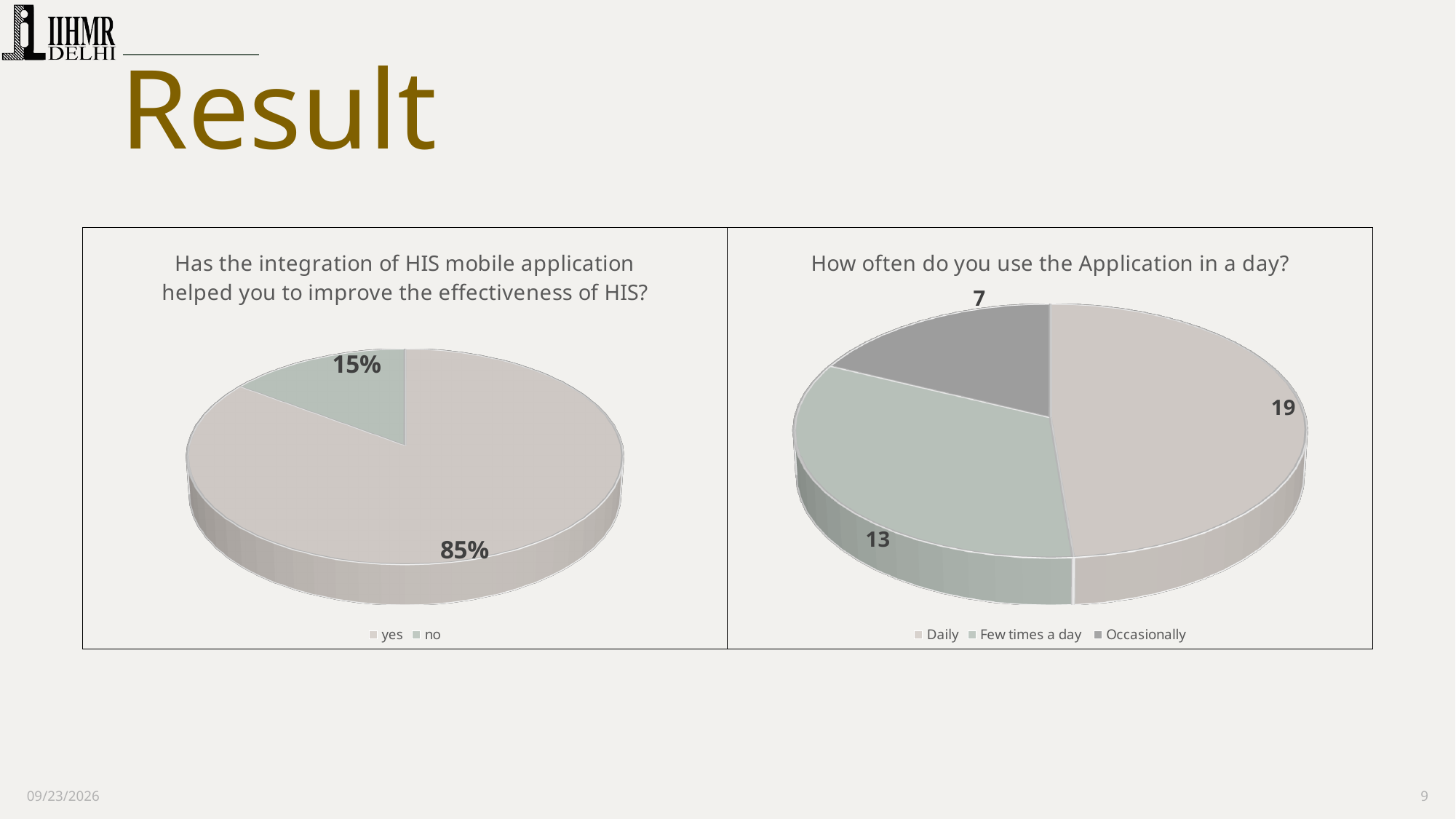
In the left chart, what is the difference in percentage points between the 'yes' and 'no' slices? 70 In the right chart, what is the difference between the 'Daily' and 'Few times a day' values? 6 In the right chart titled 'How often do you use the Application in a day?', what is the value for 'Daily'? 19 What kind of chart is the left chart on the slide? Pie chart In the left chart, which response has the larger share, 'yes' or 'no'? yes In the right chart, which category has the highest value? Daily In the right chart titled 'How often do you use the Application in a day?', what is the value for 'Occasionally'? 7 In the left chart titled 'Has the integration of HIS mobile application helped you to improve the effectiveness of HIS?', what percentage answered 'no'? 15% In the right chart, which category has the lowest value? Occasionally In the right chart titled 'How often do you use the Application in a day?', what is the value for 'Few times a day'? 13 In the left chart titled 'Has the integration of HIS mobile application helped you to improve the effectiveness of HIS?', what percentage answered 'yes'? 85% How many categories does the legend of the right chart list? 3